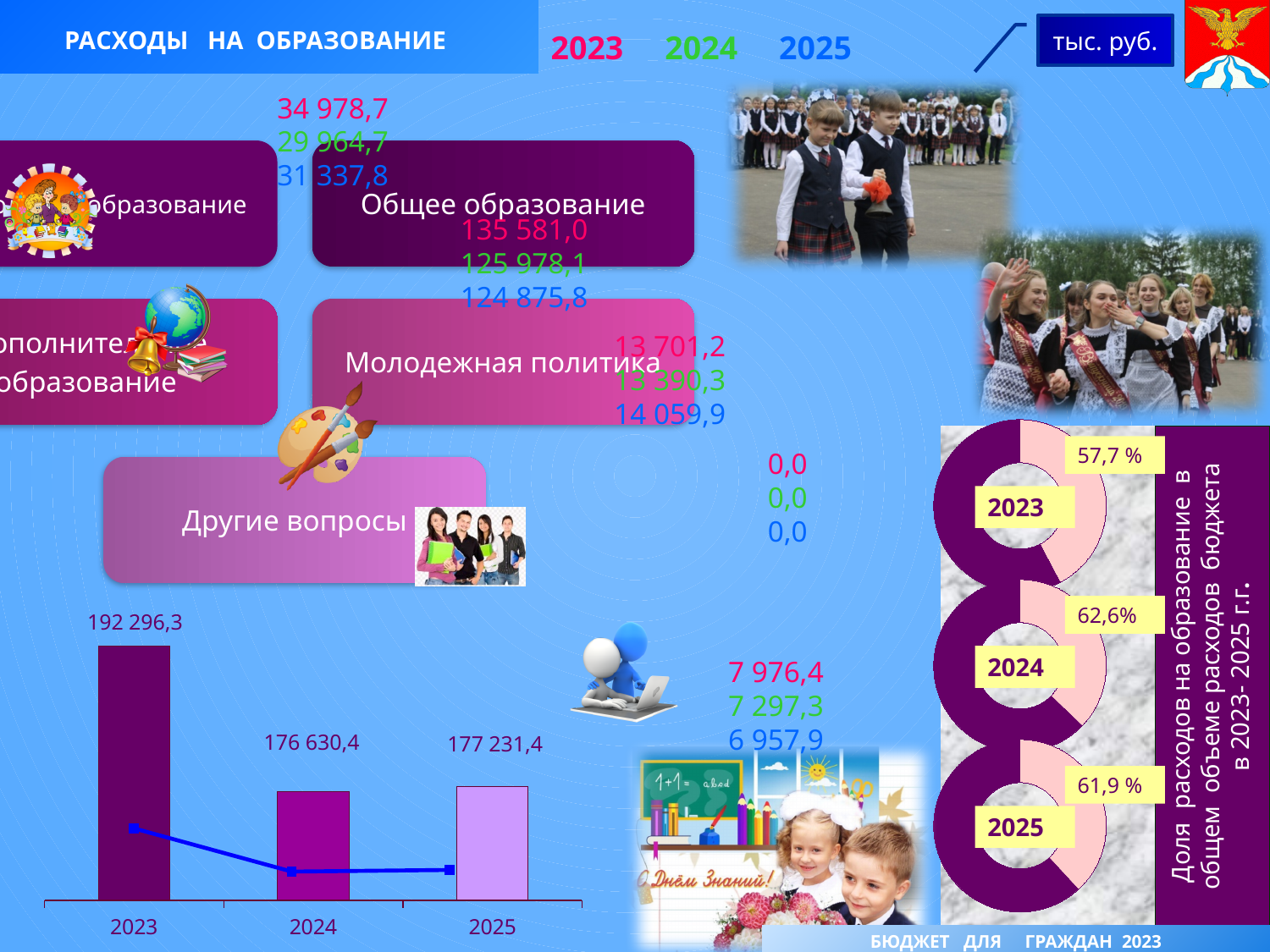
In the bar chart at the bottom left of the slide, what is the value for 2024? 176 630,4 What unit of measurement is indicated at the top of the slide for the values shown? тыс. руб. What kind of chart is shown at the bottom left of the slide? Bar chart How many years are shown on the x axis of the bar chart at the bottom left of the slide? 3 In the bar chart at the bottom left of the slide, which year has the larger value, 2024 or 2025? 2025 In the bar chart at the bottom left of the slide, what is the difference between the 2023 value and the 2024 value? 15 665,9 In the bar chart at the bottom left of the slide, what is the difference between the 2023 value and the 2025 value? 15 064,9 In the bar chart at the bottom left of the slide, what is the value for 2023? 192 296,3 In the bar chart at the bottom left of the slide, does the value rise or fall from 2023 to 2024? Fall In the bar chart at the bottom left of the slide, what is the value for 2025? 177 231,4 In the bar chart at the bottom left of the slide, which year has the highest value? 2023 In the bar chart at the bottom left of the slide, which year has the lowest value? 2024